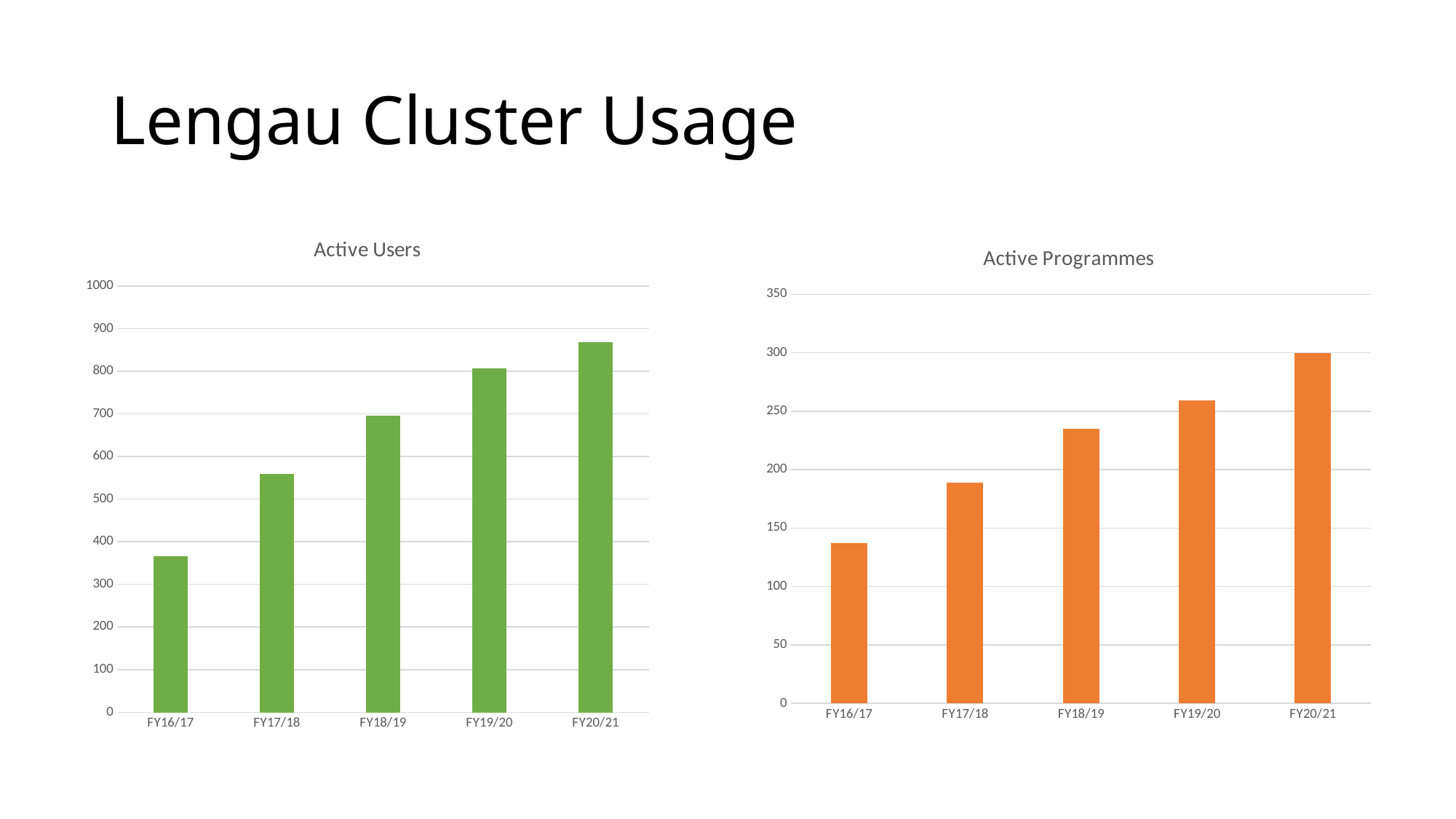
What kind of chart is the Active Users chart? bar chart On the Active Programmes chart, which fiscal year has the lowest value? FY16/17 On the Active Users chart, which fiscal year has the highest value? FY20/21 On the Active Programmes chart, is the value for FY18/19 greater or less than 200? greater On the Active Users chart, do the values rise or fall from FY16/17 to FY20/21? rise How many fiscal years are shown on the Active Programmes chart? 5 On the Active Users chart, is the value for FY16/17 greater or less than 400? less On the Active Programmes chart, which fiscal year has the highest value? FY20/21 What is the title of the chart on the right side of the slide? Active Programmes On the Active Programmes chart, which is larger, the value for FY17/18 or the value for FY19/20? FY19/20 On the Active Users chart, which fiscal year has the lowest value? FY16/17